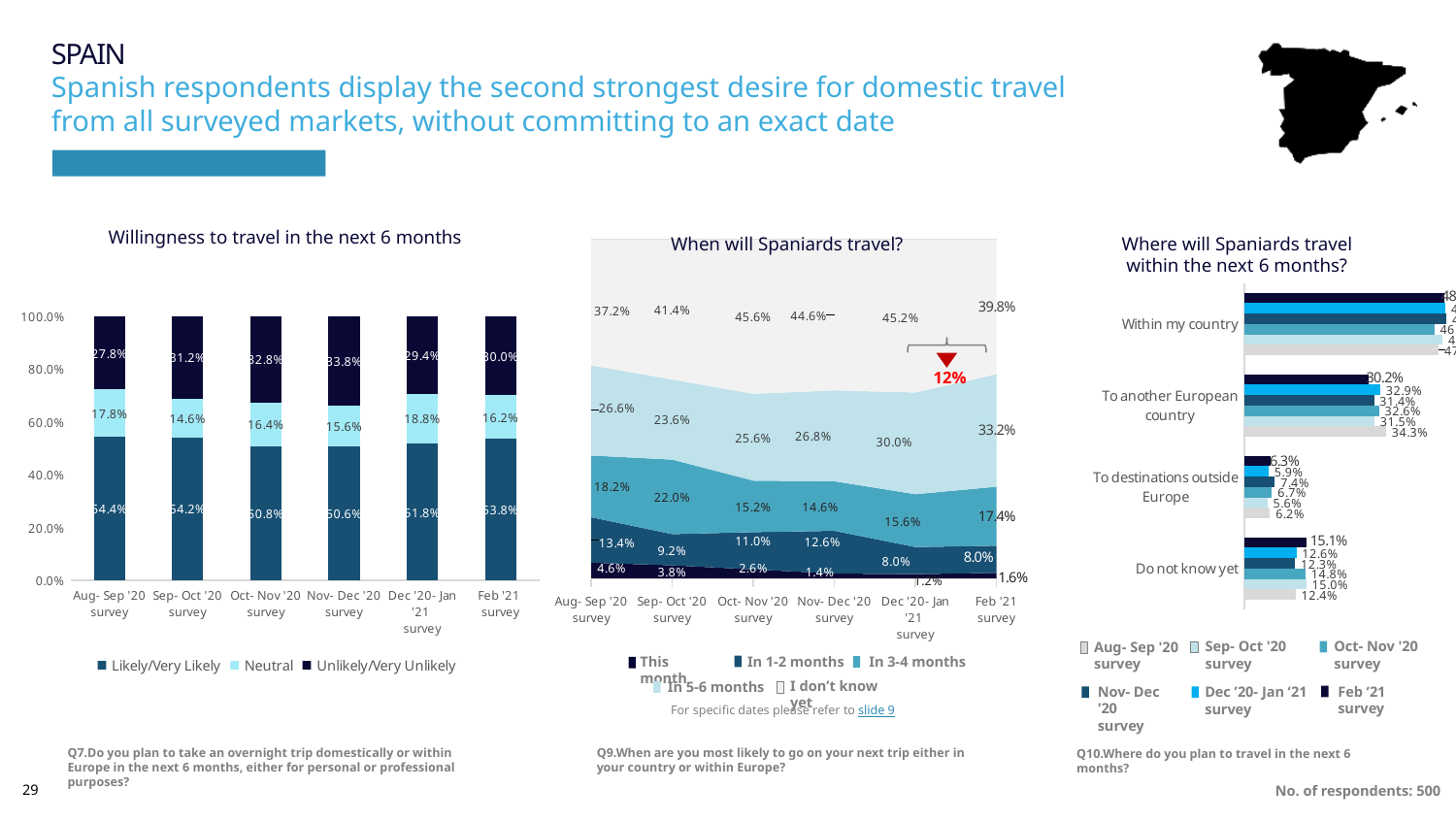
In the 'Willingness to travel in the next 6 months' chart, how many series does the legend list? 3 What kind of chart is 'Willingness to travel in the next 6 months'? Stacked bar chart In the 'When will Spaniards travel?' chart, what is the 'I don't know yet' value for the Oct- Nov '20 survey? 45.6% In the 'When will Spaniards travel?' chart, what is the 'This month' value for the Feb '21 survey? 1.6% In the 'Willingness to travel in the next 6 months' chart, what is the Likely/Very Likely value for the Aug- Sep '20 survey? 54.4% In the 'Willingness to travel in the next 6 months' chart, what is the difference between the Likely/Very Likely values for the Aug- Sep '20 survey and the Nov- Dec '20 survey? 3.8% In the 'When will Spaniards travel?' chart, which survey has the highest 'In 5-6 months' value? Feb '21 survey In the 'Willingness to travel in the next 6 months' chart, what is the Unlikely/Very Unlikely value for the Nov- Dec '20 survey? 33.8% In the 'When will Spaniards travel?' chart, how many surveys are shown on the x axis? 6 In the 'Willingness to travel in the next 6 months' chart, which survey has the highest Neutral value? Dec '20- Jan '21 survey In the 'Where will Spaniards travel within the next 6 months?' chart, which is larger for 'Do not know yet': the Aug- Sep '20 survey or the Sep- Oct '20 survey? Sep- Oct '20 survey In the 'Where will Spaniards travel within the next 6 months?' chart, what is the Feb '21 survey value for 'To another European country'? 30.2%